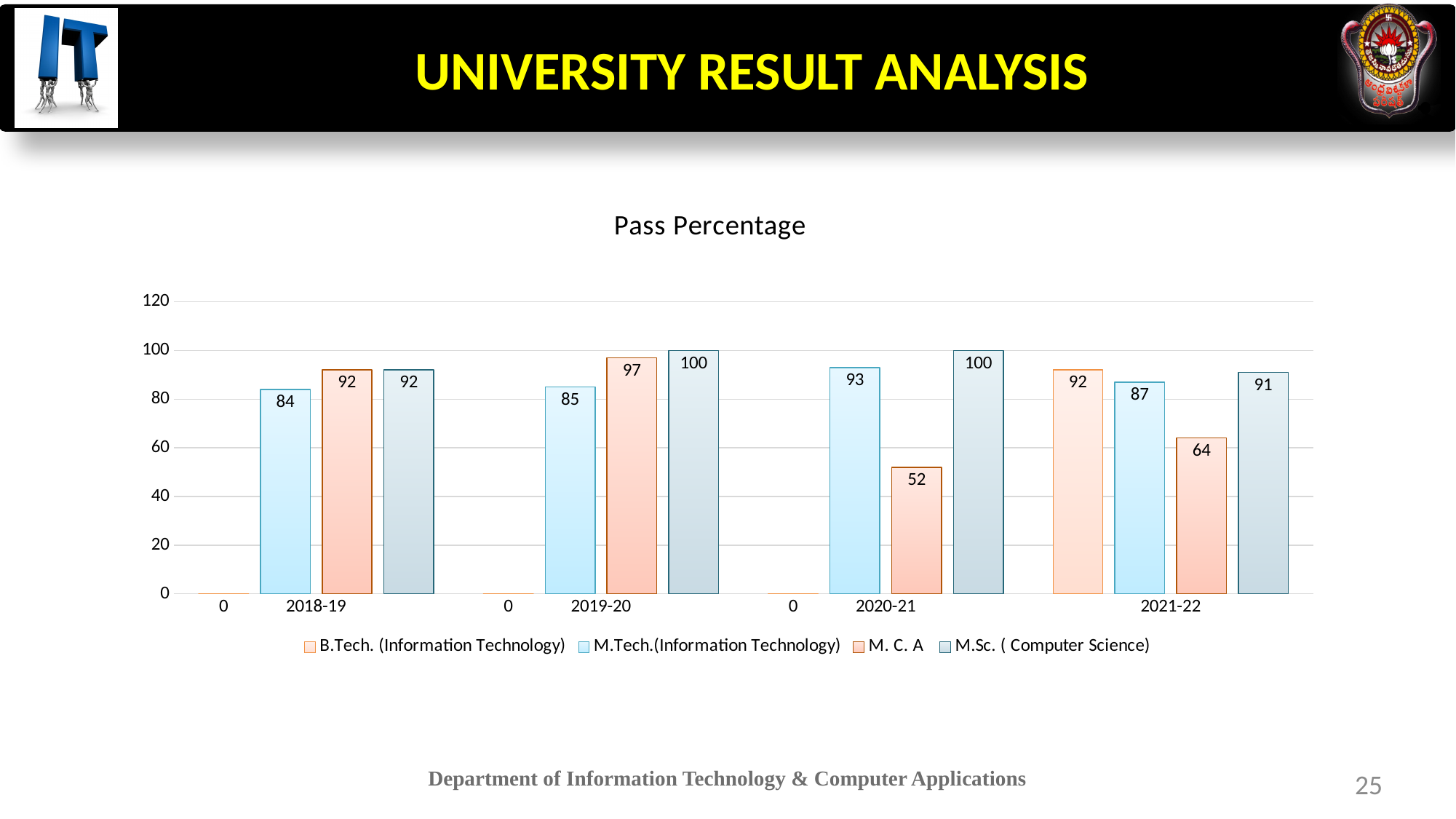
What is the title of the chart? Pass Percentage What is the pass percentage for M.Tech.(Information Technology) in 2018-19? 84 How many series does the legend list? 4 In which year is the M.Tech.(Information Technology) pass percentage highest? 2020-21 What is the pass percentage for M.Sc. ( Computer Science) in 2019-20? 100 Which is larger in 2021-22, the M.Tech.(Information Technology) or the M. C. A pass percentage? M.Tech.(Information Technology) Does the M. C. A pass percentage rise or fall from 2019-20 to 2020-21? Fall In which year is the M. C. A pass percentage lowest? 2020-21 What is the pass percentage for M. C. A in 2020-21? 52 What kind of chart is shown on the slide? Bar chart What is the difference between the M.Sc. ( Computer Science) and M. C. A pass percentages in 2020-21? 48 What is the pass percentage for B.Tech. (Information Technology) in 2021-22? 92